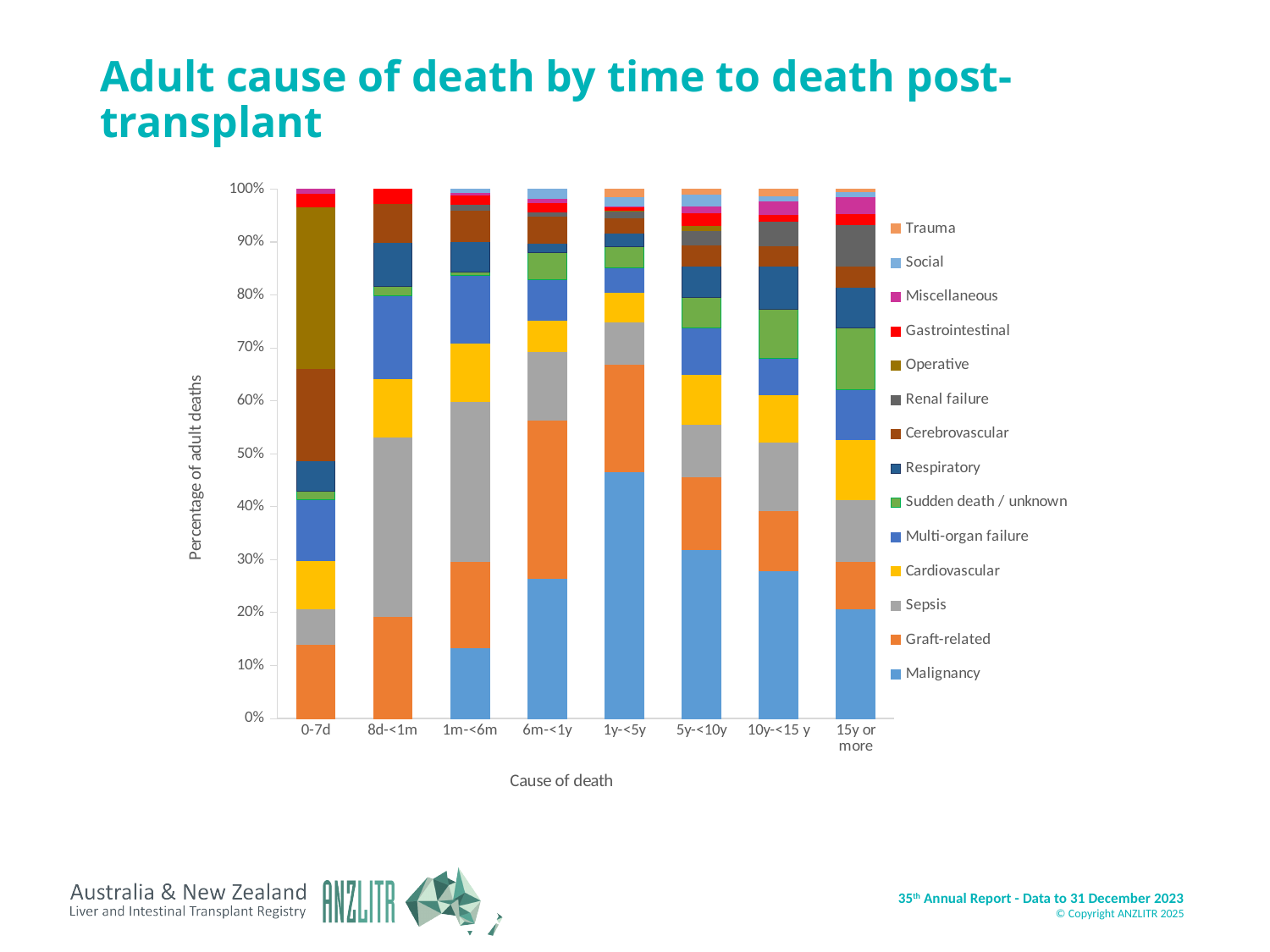
What is the label on the vertical axis? Percentage of adult deaths Which category has the largest Malignancy segment? 1y-<5y Is the Malignancy share for the 1y-<5y category greater or less than 40%? greater Which is larger, the Malignancy share in the 1y-<5y category or in the 15y or more category? 1y-<5y What kind of chart is shown on the slide? Stacked bar chart How many series does the legend list? 14 Is the Malignancy share for the 15y or more category greater or less than 30%? less How many time-to-death categories are shown along the x axis? 8 What is the title of the chart? Adult cause of death by time to death post-transplant Is the Graft-related share for the 0-7d category greater or less than 20%? less What is the total of the stacked bar for the 0-7d category? 100%